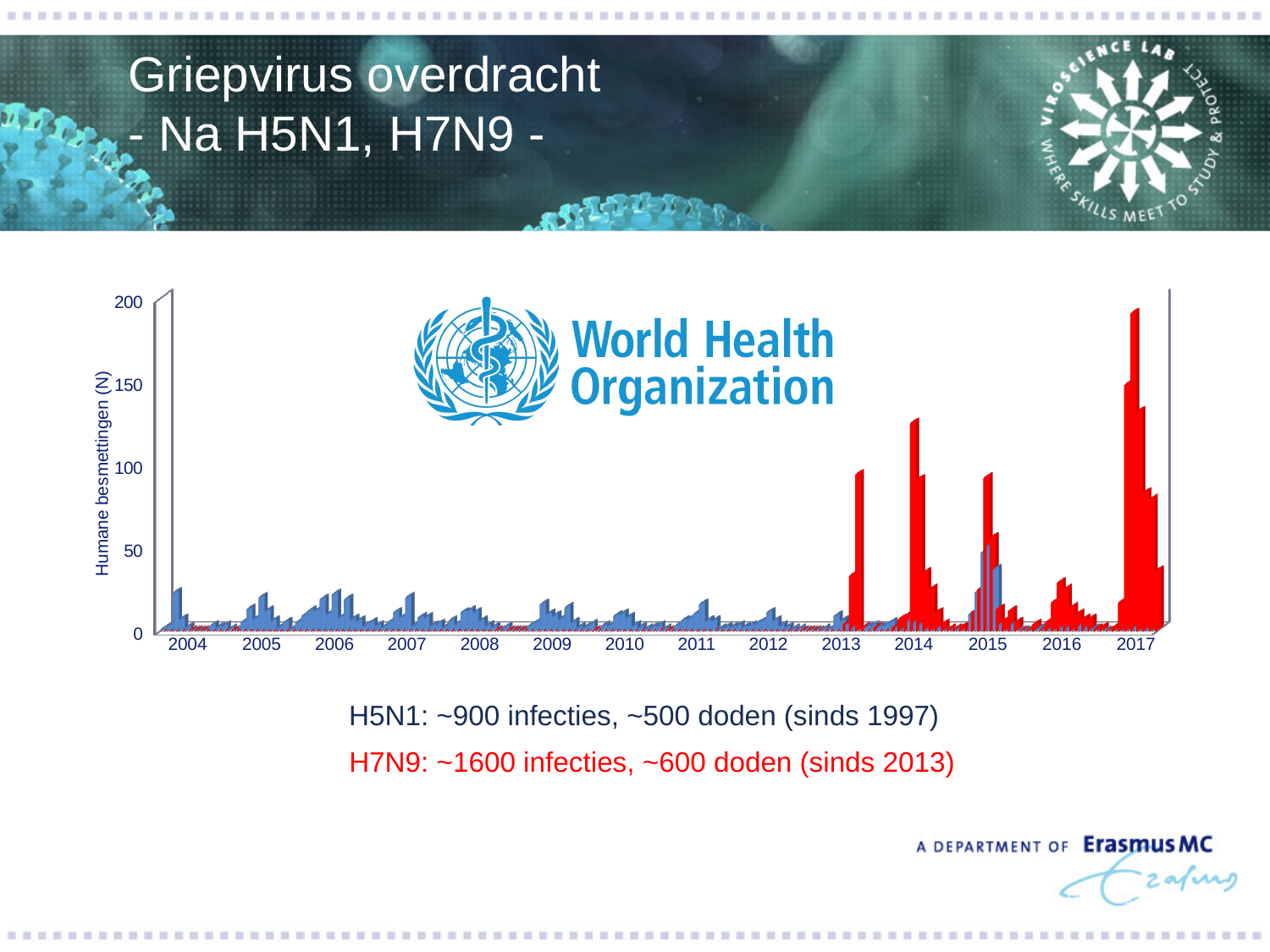
Is the tallest bar in 2017 greater or less than 150? greater Which year has the taller peak bar, 2013 or 2014? 2014 Which year has the taller peak bar, 2015 or 2016? 2015 Is the tallest bar in 2004 greater or less than 50? less In which year do the red bars first appear in the chart? 2013 What kind of chart is shown on the slide? Bar chart How many year labels are shown along the x-axis of the chart? 14 What is the label of the y-axis of the chart? Humane besmettingen (N) Is the tallest bar in 2014 greater or less than 100? greater In which year does the chart show its tallest bar? 2017 What is the highest value shown on the y-axis of the chart? 200